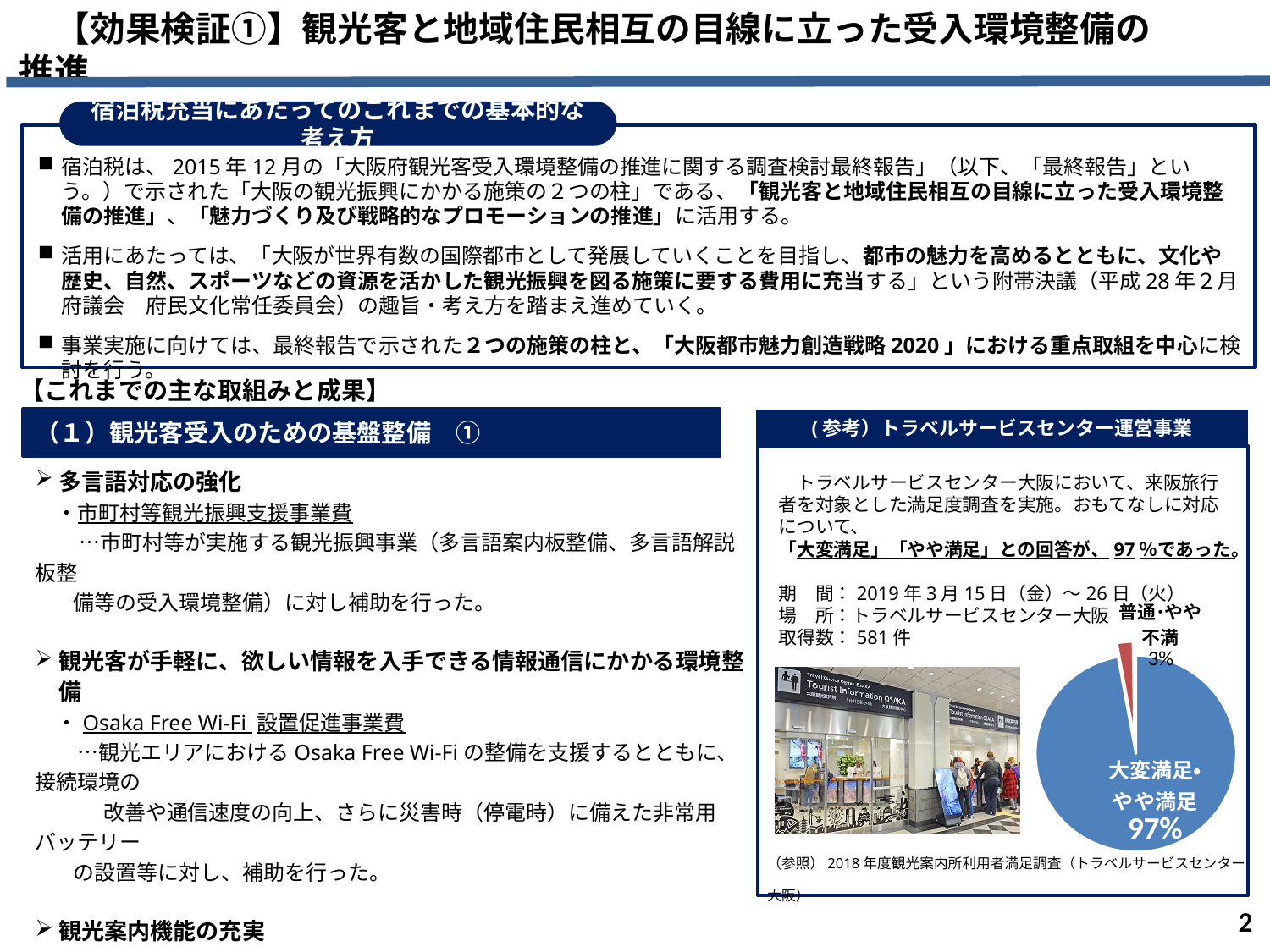
What share of the pie chart is labelled 大変満足・やや満足? 97% What colour is the 大変満足・やや満足 slice of the pie chart? blue Which slice of the pie chart is the largest? 大変満足・やや満足 Which is larger in the pie chart, 大変満足・やや満足 or 普通・やや不満? 大変満足・やや満足 What kind of chart is shown on the slide? pie chart What is the difference in percentage points between the 大変満足・やや満足 slice and the 普通・やや不満 slice? 94 What is the combined percentage of the two slices in the pie chart? 100% What share of the pie chart is labelled 普通・やや不満? 3% What colour is the 普通・やや不満 slice of the pie chart? red